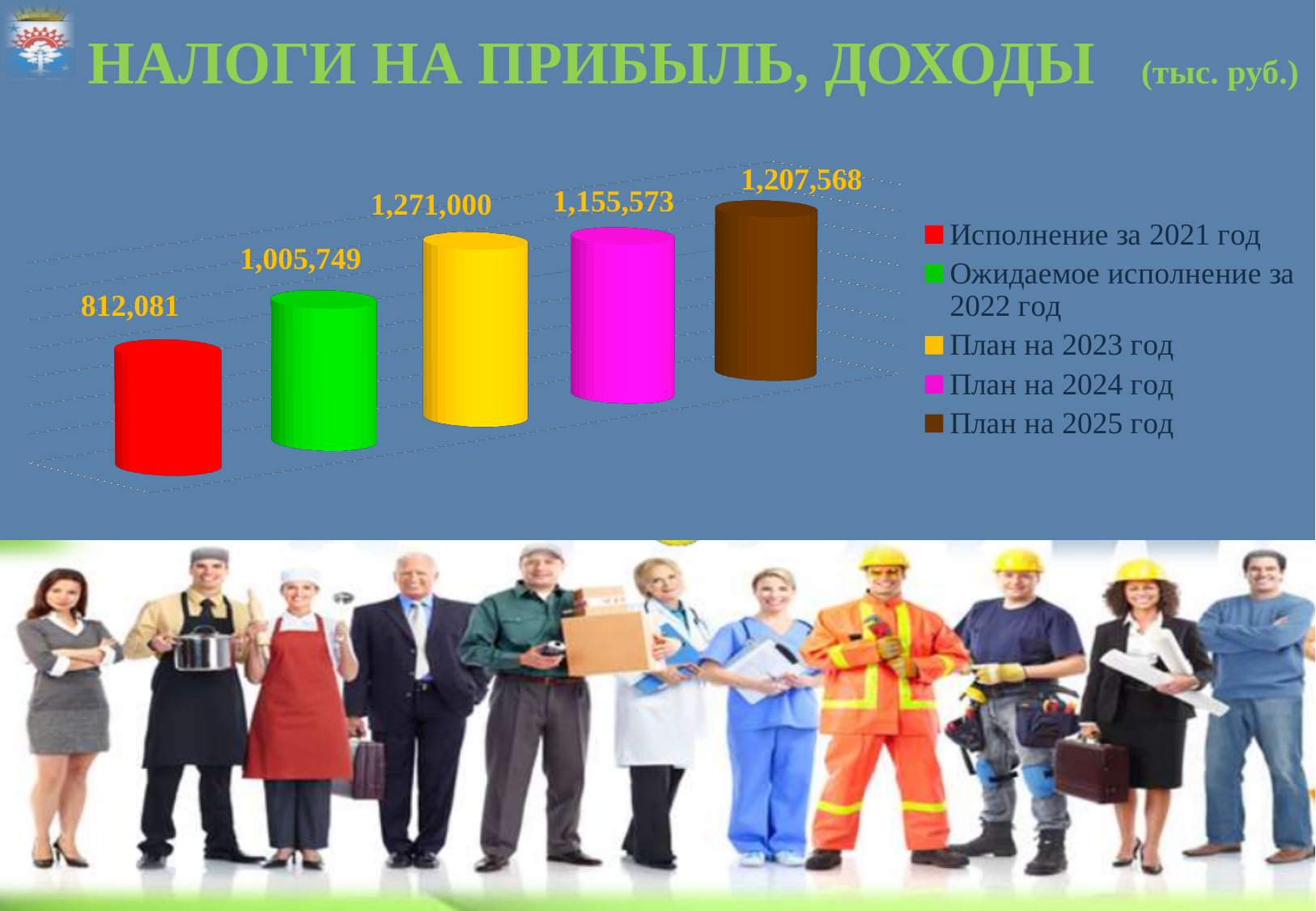
What is the value for План на 2023 год? 1,271,000 Which legend entry has the lowest value? Исполнение за 2021 год What is the value for Ожидаемое исполнение за 2022 год? 1,005,749 How many series does the legend list? 5 What is the difference between the values for План на 2023 год and Исполнение за 2021 год? 458,919 What is the value for Исполнение за 2021 год? 812,081 What kind of chart is shown on the slide? Bar chart How many bars are plotted on the chart? 5 Which legend entry has the highest value? План на 2023 год What is the value for План на 2025 год? 1,207,568 What is the difference between the values for План на 2025 год and План на 2024 год? 51,995 Which is larger, the value for План на 2024 год or the value for План на 2025 год? План на 2025 год